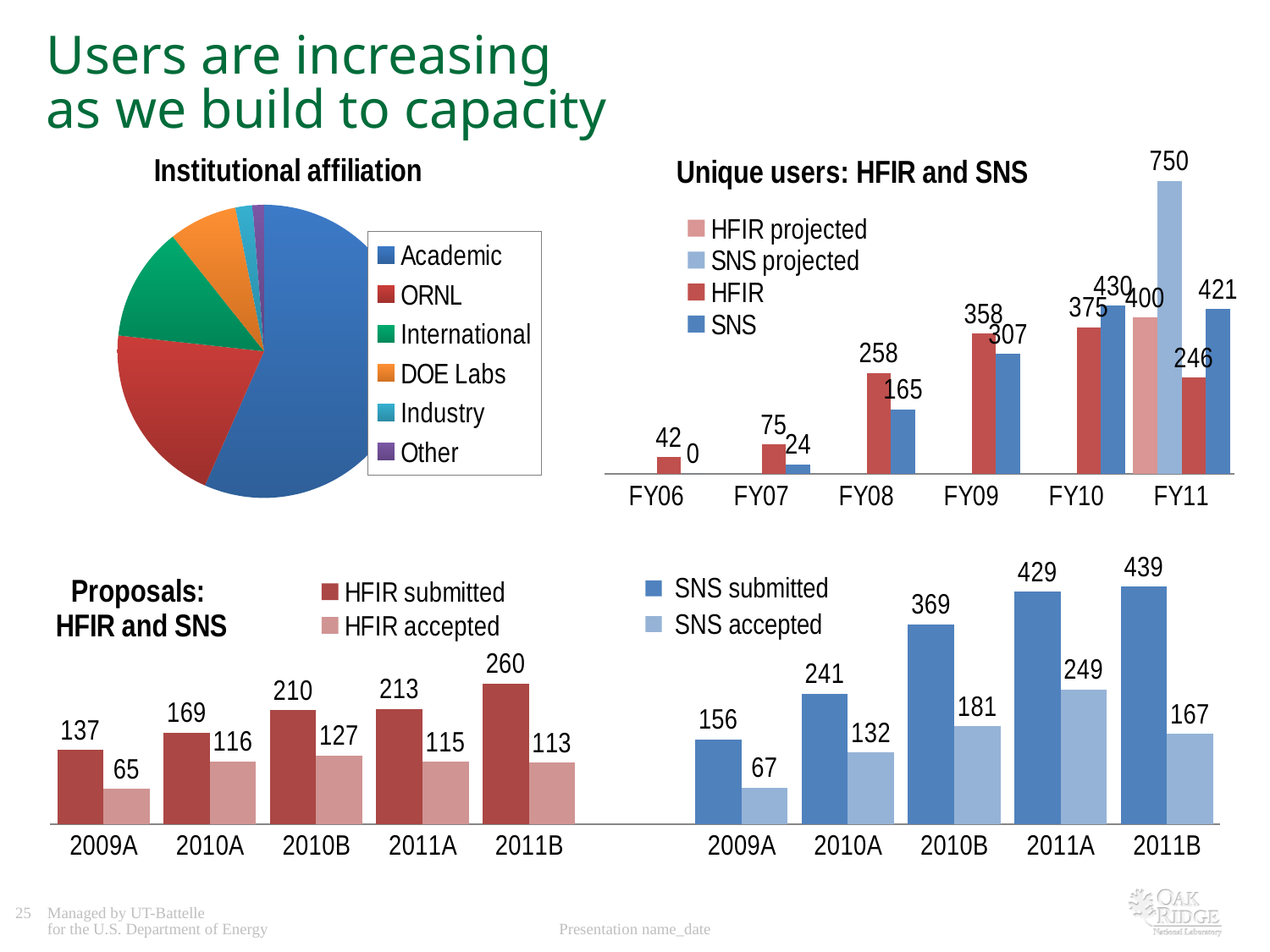
In the 'Proposals: HFIR and SNS' chart, what is the difference between SNS submitted and SNS accepted for 2011A? 180 In the 'Unique users: HFIR and SNS' chart, which is larger for FY10, HFIR or SNS? SNS In the 'Unique users: HFIR and SNS' chart, what is the SNS projected value for FY11? 750 In the 'Institutional affiliation' pie chart, which category has the largest slice? Academic In the 'Unique users: HFIR and SNS' chart, what is the difference between the HFIR and SNS values for FY08? 93 In the 'Unique users: HFIR and SNS' chart, do the SNS values rise or fall from FY06 to FY10? rise In the 'Unique users: HFIR and SNS' chart, what is the HFIR value for FY09? 358 In the 'Proposals: HFIR and SNS' chart, what is the HFIR accepted value for 2010B? 127 In the 'Institutional affiliation' chart, what kind of chart is shown? pie chart In the 'Unique users: HFIR and SNS' chart, how many series does the legend list? 4 In the 'Proposals: HFIR and SNS' chart, which period has the highest SNS submitted value? 2011B In the 'Institutional affiliation' pie chart, how many categories does the legend list? 6